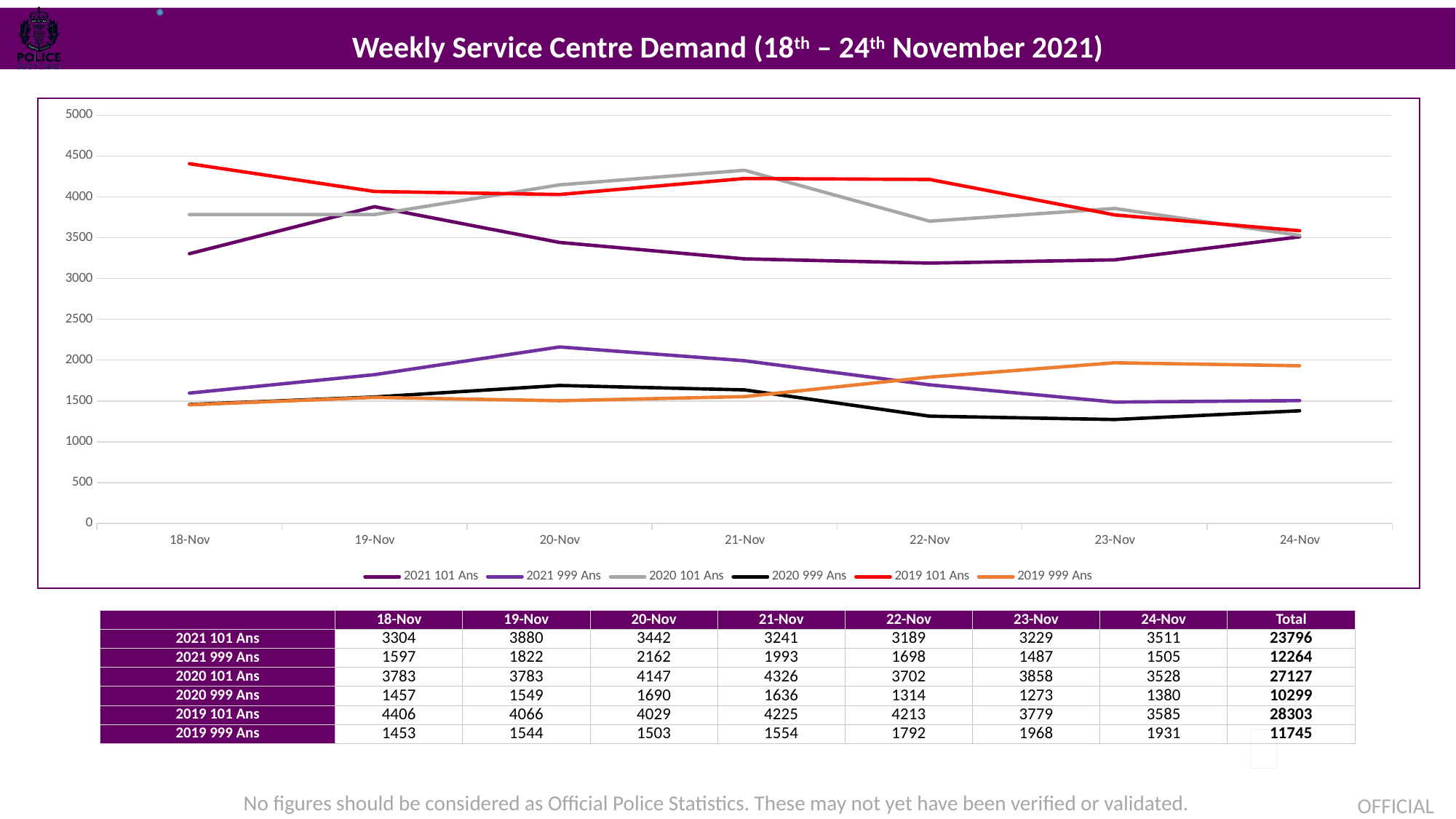
What is the title of the slide containing the chart? Weekly Service Centre Demand (18th – 24th November 2021) What is the value for 2019 101 Ans on 18-Nov? 4406 What is the value for 2021 101 Ans on 19-Nov? 3880 How many dates are plotted along the x axis of the chart? 7 Which is larger on 22-Nov: 2019 999 Ans or 2021 999 Ans? 2019 999 Ans Does the 2019 999 Ans series generally rise or fall from 18-Nov to 24-Nov? Rise What is the value for 2021 999 Ans on 20-Nov? 2162 What kind of chart is shown on the slide? Line chart How many series does the chart legend list? 6 On which date is the 2020 999 Ans series at its lowest? 23-Nov What is the difference between 2019 101 Ans and 2021 101 Ans on 18-Nov? 1102 On which date is the 2020 101 Ans series at its highest? 21-Nov